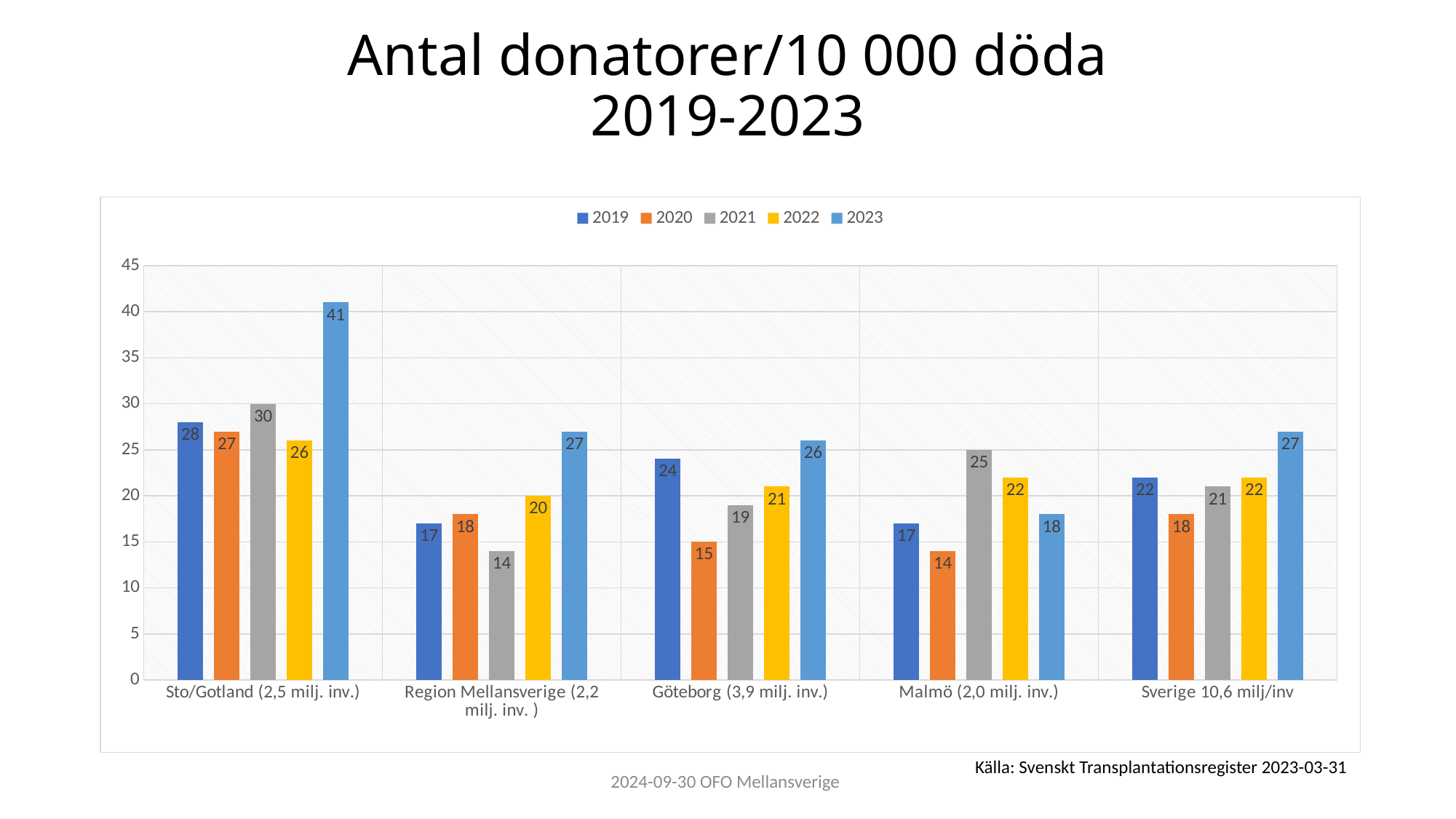
What is the value for Sto/Gotland (2,5 milj. inv.) in 2023? 41 What is the value for Malmö (2,0 milj. inv.) in 2021? 25 Which category has the lowest value in 2021? Region Mellansverige (2,2 milj. inv. ) How many series does the legend list? 5 How many categories are shown on the x axis? 5 What is the value for Göteborg (3,9 milj. inv.) in 2020? 15 Which category has the highest value in 2023? Sto/Gotland (2,5 milj. inv.) What is the value for Sverige 10,6 milj/inv in 2022? 22 What is the difference between the 2023 and 2019 values for Sto/Gotland (2,5 milj. inv.)? 13 What kind of chart is shown on the slide? Bar chart What is the title of the chart? Antal donatorer/10 000 döda 2019-2023 Which is larger for Malmö (2,0 milj. inv.): the 2021 value or the 2023 value? 2021